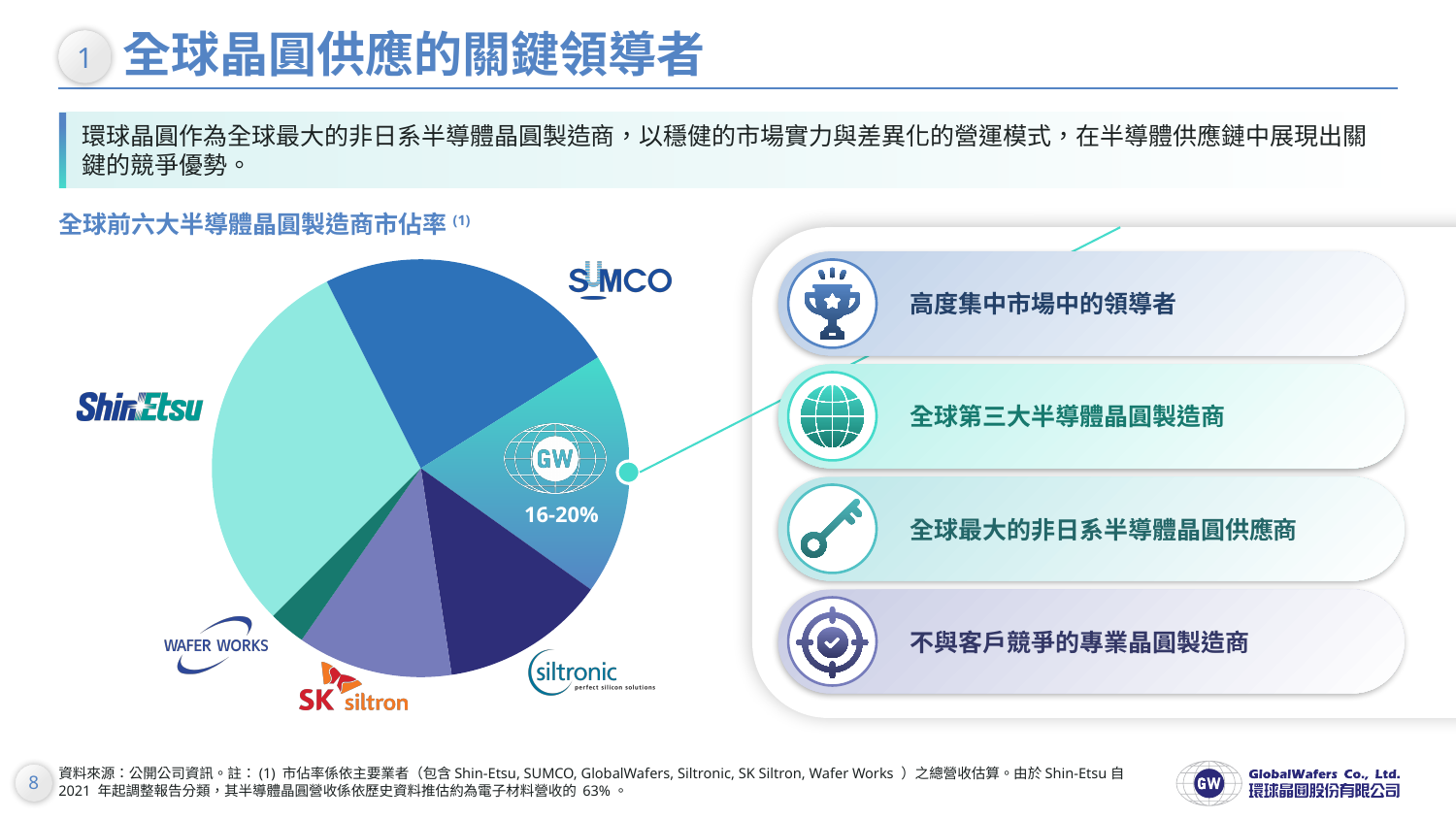
Which slice is larger in the pie chart, SUMCO or Siltronic? SUMCO Which slice is larger in the pie chart, GlobalWafers (GW) or Wafer Works? GlobalWafers (GW) Which company's slice in the pie chart is the only one with a printed value label? GlobalWafers (GW) Which slice is larger in the pie chart, SK siltron or Wafer Works? SK siltron What kind of chart is shown on the slide? pie chart What is the title of the pie chart? 全球前六大半導體晶圓製造商市佔率 Which company has the smallest slice in the pie chart? Wafer Works What market share is printed for GlobalWafers (GW) in the pie chart? 16-20% How many slices does the pie chart have? 6